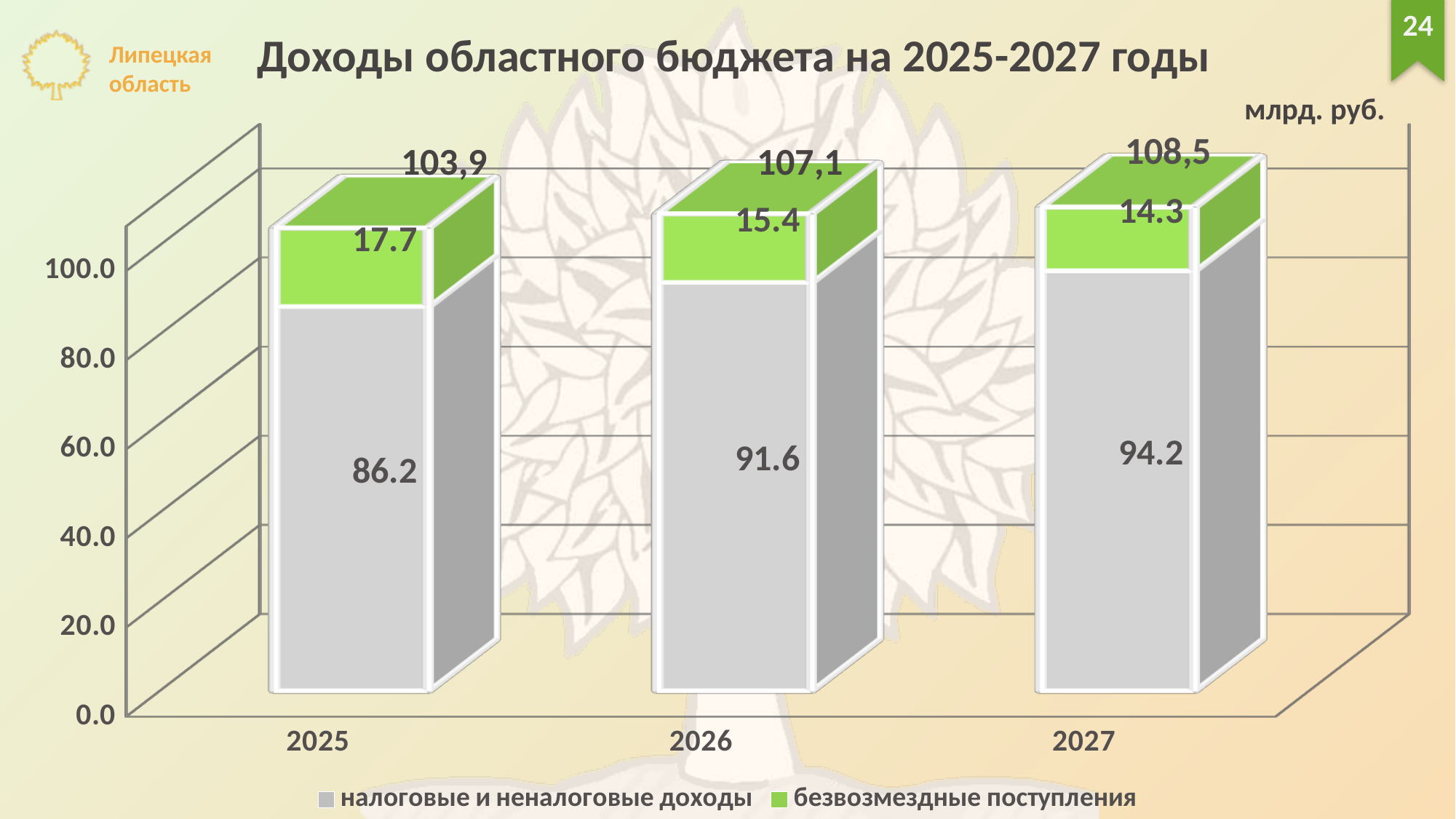
How many series does the legend list? 2 Which is larger: безвозмездные поступления in 2025 or in 2026? 2025 What kind of chart is shown on the slide? stacked bar chart Which year has the lowest value for безвозмездные поступления? 2027 Do the totals above the bars rise or fall from 2025 to 2027? rise What is the value of безвозмездные поступления for 2025? 17.7 What is the total shown above the bar for 2027? 108,5 Is the value for налоговые и неналоговые доходы in 2025 greater or less than 80.0? greater How many years are shown on the x axis? 3 Which year has the highest value for налоговые и неналоговые доходы? 2027 What is the value of налоговые и неналоговые доходы for 2026? 91.6 What is the difference between налоговые и неналоговые доходы in 2027 and in 2025? 8.0